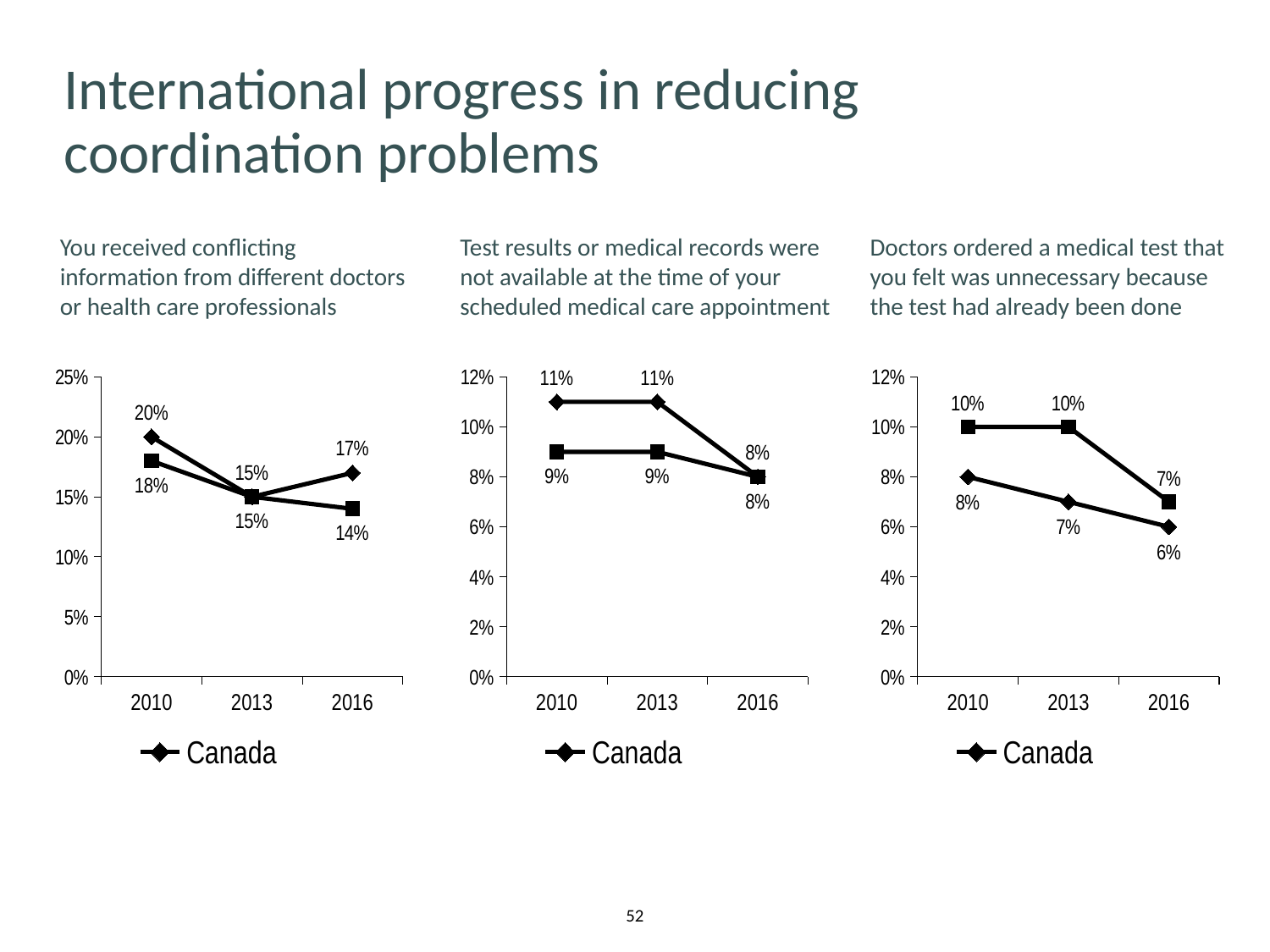
In the right chart ('Doctors ordered a medical test that you felt was unnecessary...'), does the Canada value rise or fall from 2010 to 2016? fall What kind of chart is the left chart ('You received conflicting information...')? line chart In the middle chart ('Test results or medical records were not available...'), what is the value for Canada in 2010? 11% In the left chart ('You received conflicting information from different doctors or health care professionals'), what is the value for Canada in 2010? 20% In the left chart ('You received conflicting information...'), in which year is the Canada value highest? 2010 In the right chart ('Doctors ordered a medical test that you felt was unnecessary...'), what is the difference between the Canada values for 2010 and 2016? 2 percentage points In the right chart ('Doctors ordered a medical test that you felt was unnecessary...'), what is the value for Canada in 2013? 7% In the middle chart ('Test results or medical records were not available...'), what is the value for Canada in 2016? 8% In the middle chart ('Test results or medical records were not available...'), is the Canada value larger in 2013 or in 2016? 2013 In the left chart ('You received conflicting information...'), what is the value for Canada in 2016? 17% How many years are shown on the x axis of the middle chart ('Test results or medical records were not available...')? 3 In the left chart ('You received conflicting information...'), what is the difference between the Canada values for 2010 and 2013? 5 percentage points